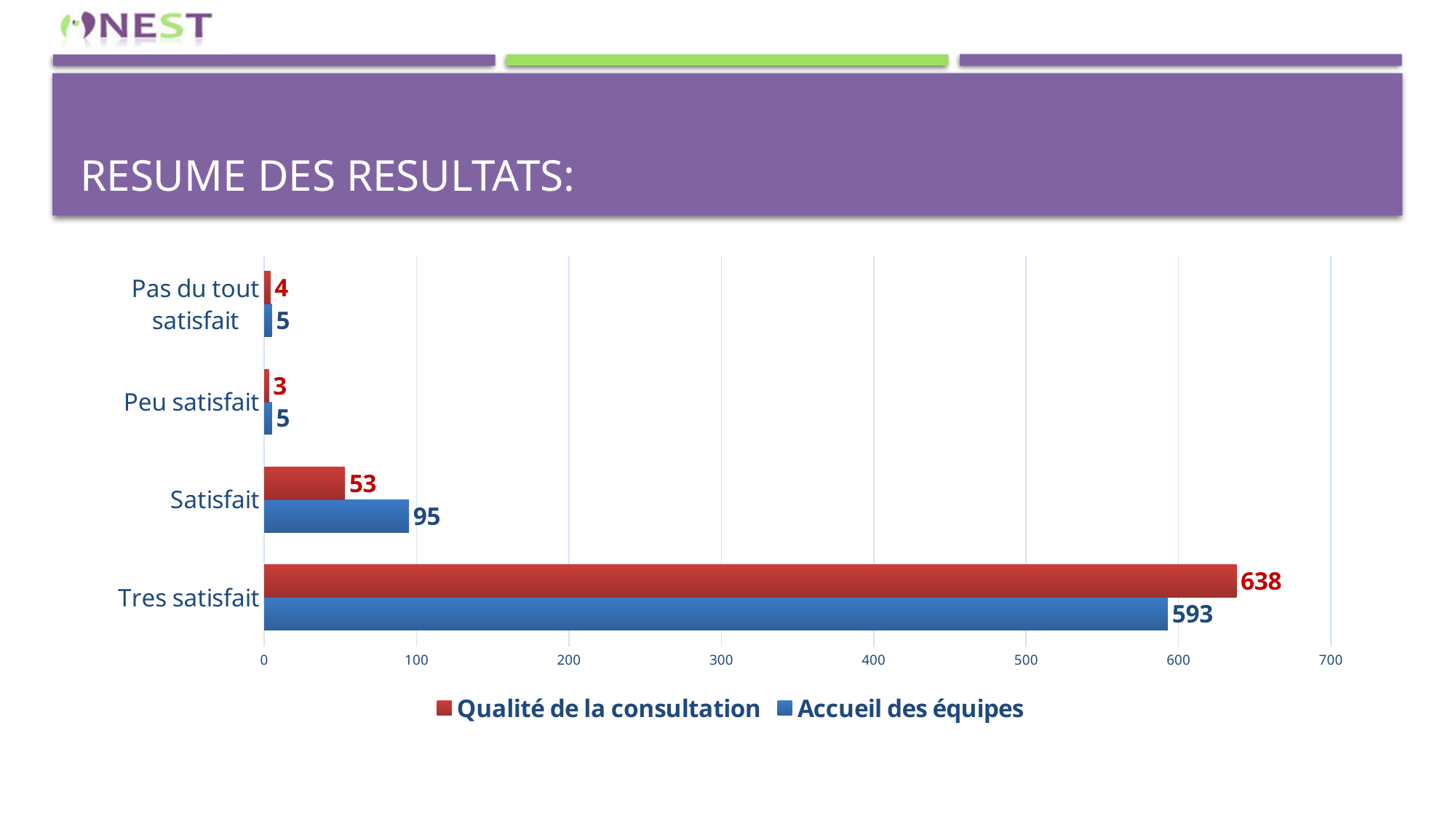
Which category has the lowest value in the Qualité de la consultation series? Peu satisfait What is the value for Satisfait in the Accueil des équipes series? 95 How many series does the legend list? 2 What kind of chart is shown on the slide? Bar chart How many categories are shown on the chart? 4 What is the value for Peu satisfait in the Qualité de la consultation series? 3 What is the value for Pas du tout satisfait in the Accueil des équipes series? 5 What is the value for Tres satisfait in the Qualité de la consultation series? 638 What is the difference between the Accueil des équipes and Qualité de la consultation values for Satisfait? 42 For Satisfait, which series has the larger value: Qualité de la consultation or Accueil des équipes? Accueil des équipes Which category has the highest value in the Accueil des équipes series? Tres satisfait What is the difference between the Qualité de la consultation and Accueil des équipes values for Tres satisfait? 45